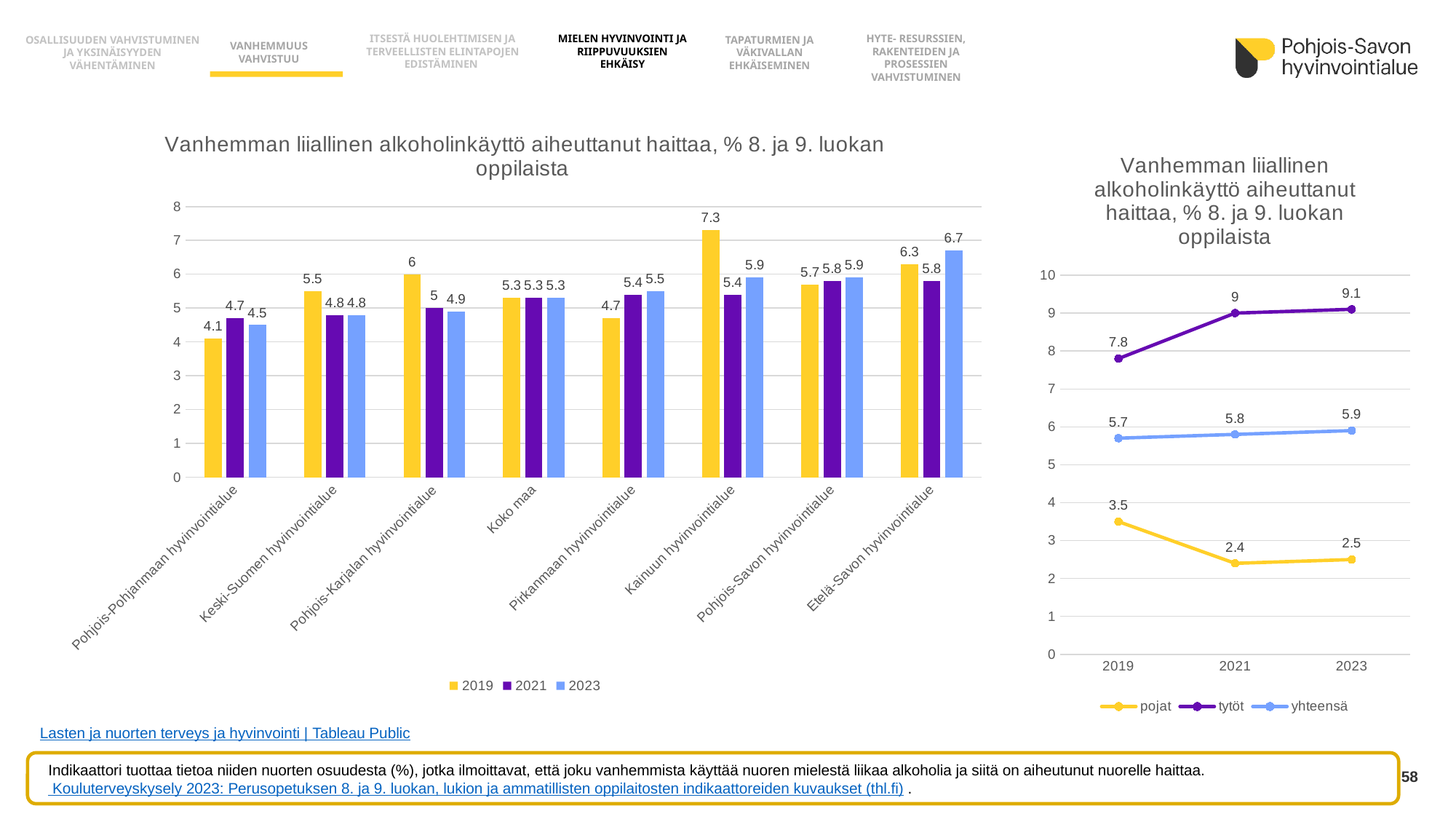
In the right line chart, how does the value for pojat change from 2019 to 2021? It falls (from 3.5 to 2.4) What kind of chart is the chart on the right side of the slide? Line chart How many regions (categories) are shown in the left bar chart? 8 In the left bar chart, what is the difference between the 2019 and 2023 values for Pohjois-Karjalan hyvinvointialue? 1.1 In the right line chart, what is the value for tytöt in 2023? 9.1 In the left bar chart, which region has the highest value in 2023? Etelä-Savon hyvinvointialue In the left bar chart, which region has the lowest value in 2019? Pohjois-Pohjanmaan hyvinvointialue In the left bar chart, what is the value for Pohjois-Savon hyvinvointialue in 2023? 5.9 In the right line chart, what is the difference between tytöt and pojat in 2019? 4.3 In the left bar chart, what is the value for Kainuun hyvinvointialue in 2019? 7.3 How many series does the legend of the left bar chart list? 3 In the left bar chart, which is larger for Pirkanmaan hyvinvointialue: the 2019 value or the 2023 value? 2023